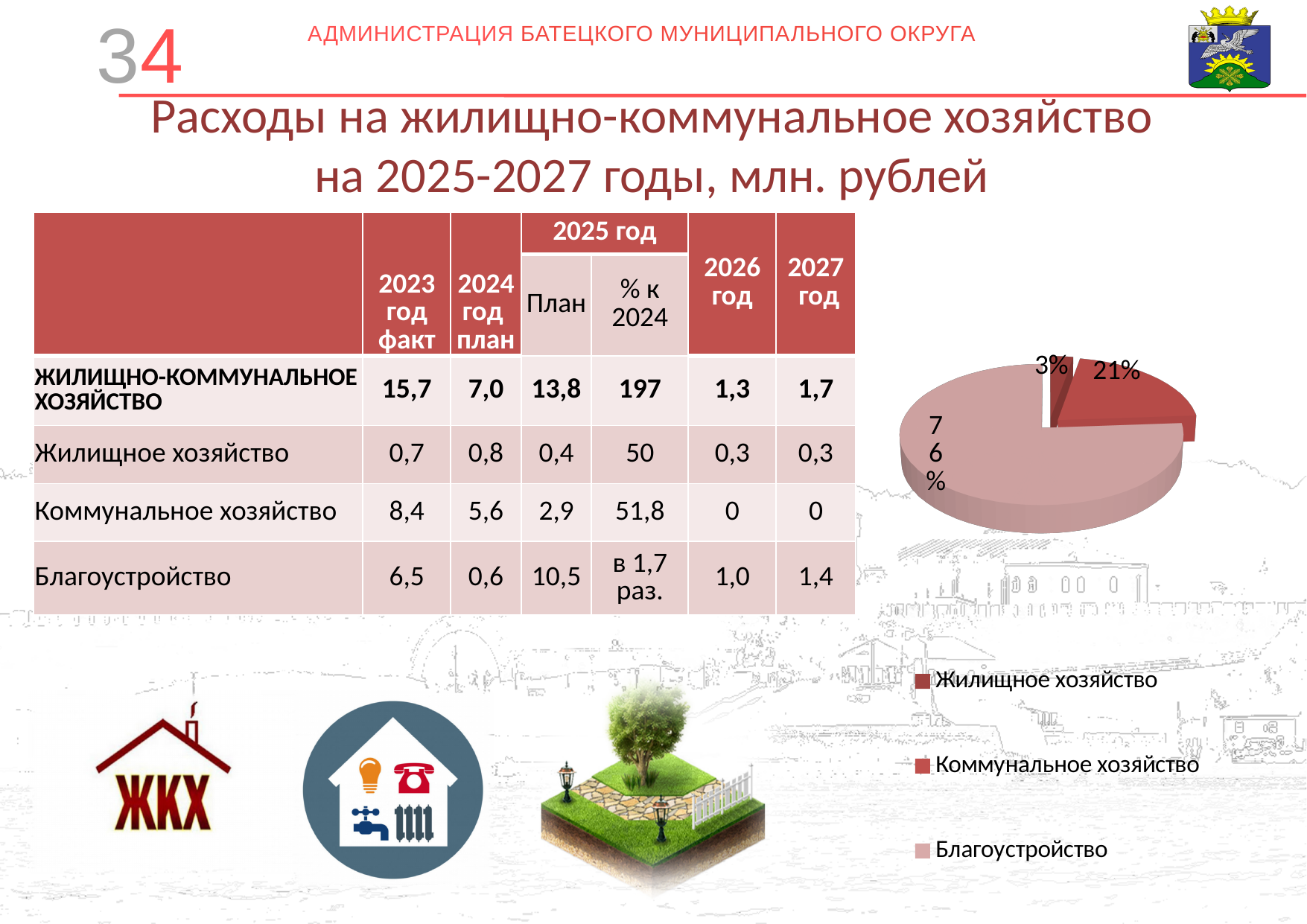
In the pie chart, what is the difference in percentage points between the Коммунальное хозяйство slice and the Жилищное хозяйство slice? 18 What share of the pie chart does Жилищное хозяйство take? 3% What share of the pie chart does Коммунальное хозяйство take? 21% Which legend entry of the pie chart is shown in the lightest pink colour? Благоустройство What share of the pie chart does Благоустройство take? 76% Which category has the largest slice in the pie chart? Благоустройство What kind of chart is shown on the slide? pie chart In the pie chart, which is larger: the slice for Коммунальное хозяйство or the slice for Жилищное хозяйство? Коммунальное хозяйство In the pie chart, what is the difference in percentage points between the Благоустройство slice and the Коммунальное хозяйство slice? 55 How many entries does the pie chart's legend list? 3 How many slices does the pie chart have? 3 Which category has the smallest slice in the pie chart? Жилищное хозяйство